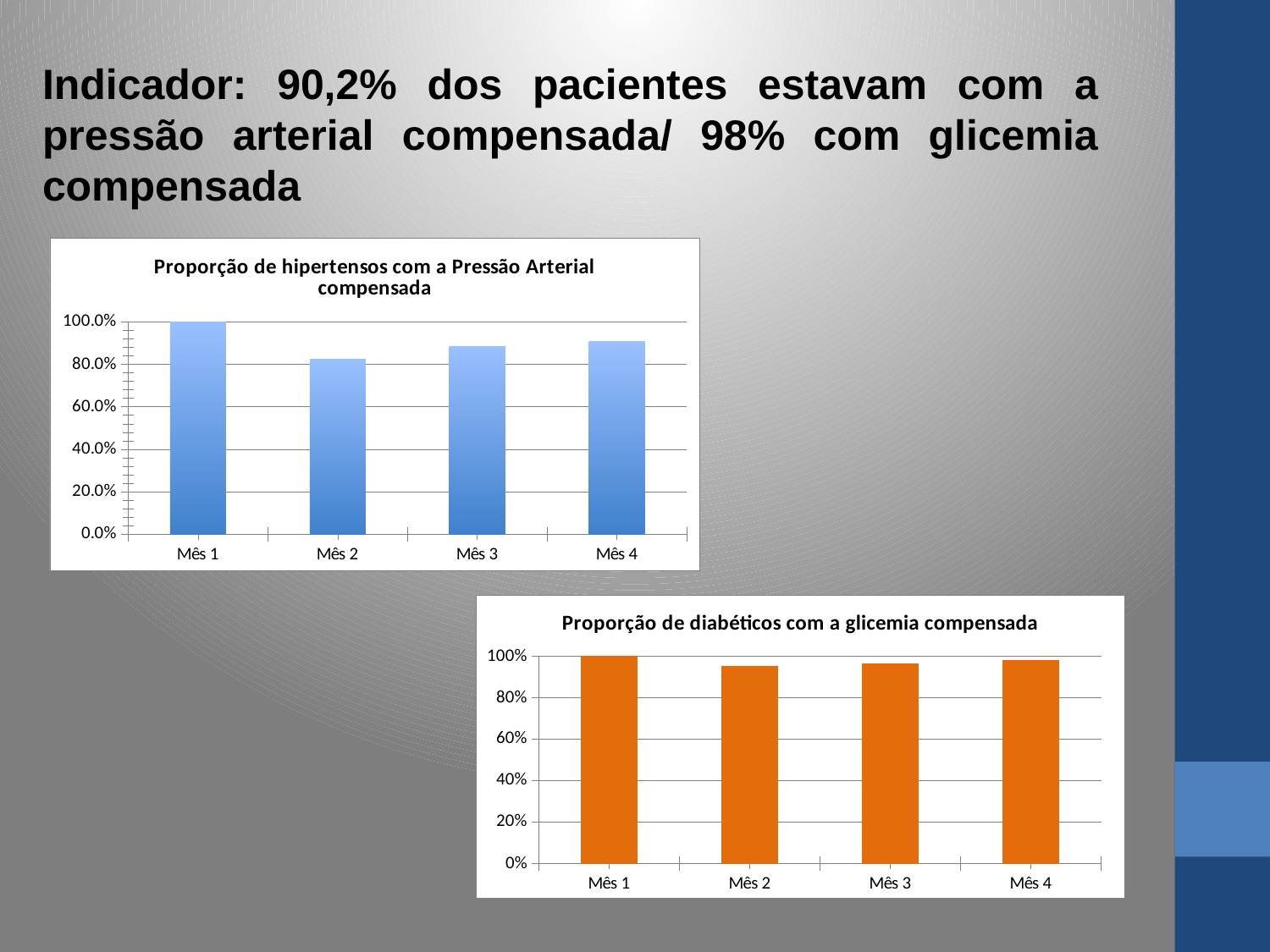
In the chart 'Proporção de hipertensos com a Pressão Arterial compensada', is the value for Mês 2 greater or less than 80.0%? greater What kind of chart is 'Proporção de hipertensos com a Pressão Arterial compensada'? bar chart In the chart 'Proporção de diabéticos com a glicemia compensada', what is the value for Mês 1? 100% In the chart 'Proporção de hipertensos com a Pressão Arterial compensada', what is the value for Mês 1? 100.0% In the chart 'Proporção de diabéticos com a glicemia compensada', is the value for Mês 2 greater or less than 80%? greater How many months are shown on the x axis of the chart 'Proporção de diabéticos com a glicemia compensada'? 4 In the chart 'Proporção de hipertensos com a Pressão Arterial compensada', is the value for Mês 3 greater or less than 100.0%? less In the chart 'Proporção de diabéticos com a glicemia compensada', which month has the highest value? Mês 1 In the chart 'Proporção de hipertensos com a Pressão Arterial compensada', which month has the lowest value? Mês 2 In the chart 'Proporção de hipertensos com a Pressão Arterial compensada', which month has the highest value? Mês 1 In the chart 'Proporção de hipertensos com a Pressão Arterial compensada', which is larger, the value for Mês 2 or Mês 3? Mês 3 In the chart 'Proporção de diabéticos com a glicemia compensada', which is larger, the value for Mês 1 or Mês 2? Mês 1